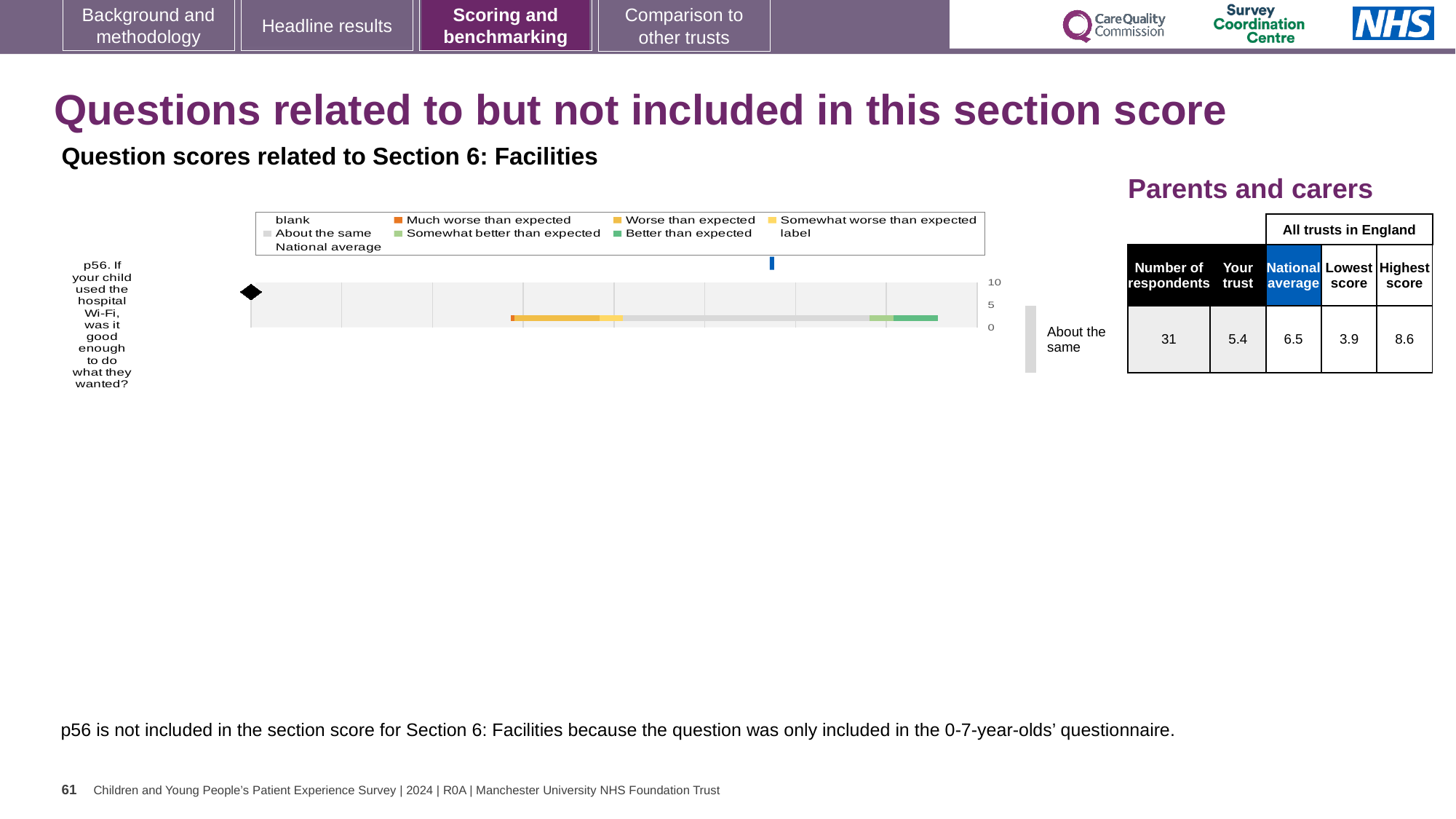
In the table next to the chart, what is the 'Your trust' score for p56? 5.4 In the table next to the chart, how many respondents answered p56? 31 In the table next to the chart, what is the Highest score across all trusts in England for p56? 8.6 Which question is plotted in the chart? p56. If your child used the hospital Wi-Fi, was it good enough to do what they wanted? Which is larger for p56, the Your trust score or the National average score? National average What kind of chart is shown on the slide? bar chart In the table next to the chart, what is the National average score for p56? 6.5 What is the difference between the National average and the Your trust score for p56? 1.1 What is the benchmark category label shown beside the chart for p56? About the same What is the difference between the Highest score and the Lowest score for p56? 4.7 How many questions (categories) are plotted in the chart? 1 In the table next to the chart, what is the Lowest score across all trusts in England for p56? 3.9